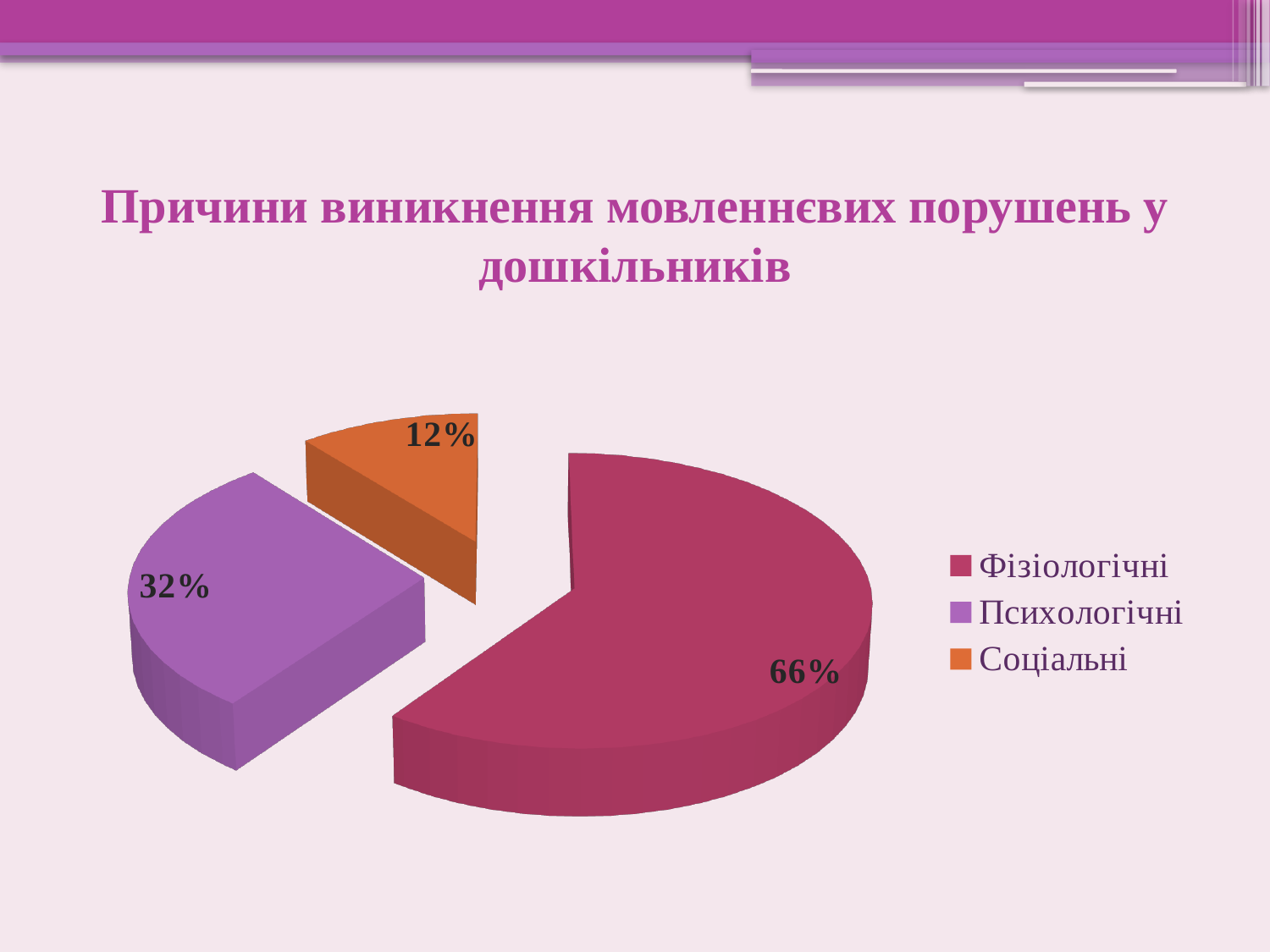
What type of chart is shown on the slide? pie chart What percentage is shown for Психологічні? 32% What colour is the slice for Соціальні? orange Which category has the largest slice of the pie? Фізіологічні What is the difference in percentage points between Фізіологічні and Психологічні? 34 Which is larger, the slice for Психологічні or the slice for Соціальні? Психологічні How many slices does the pie chart have? 3 Which category has the smallest slice of the pie? Соціальні How many entries does the legend list? 3 What percentage is shown for Соціальні? 12% What percentage is shown for Фізіологічні? 66% What is the title of the chart? Причини виникнення мовленнєвих порушень у дошкільників